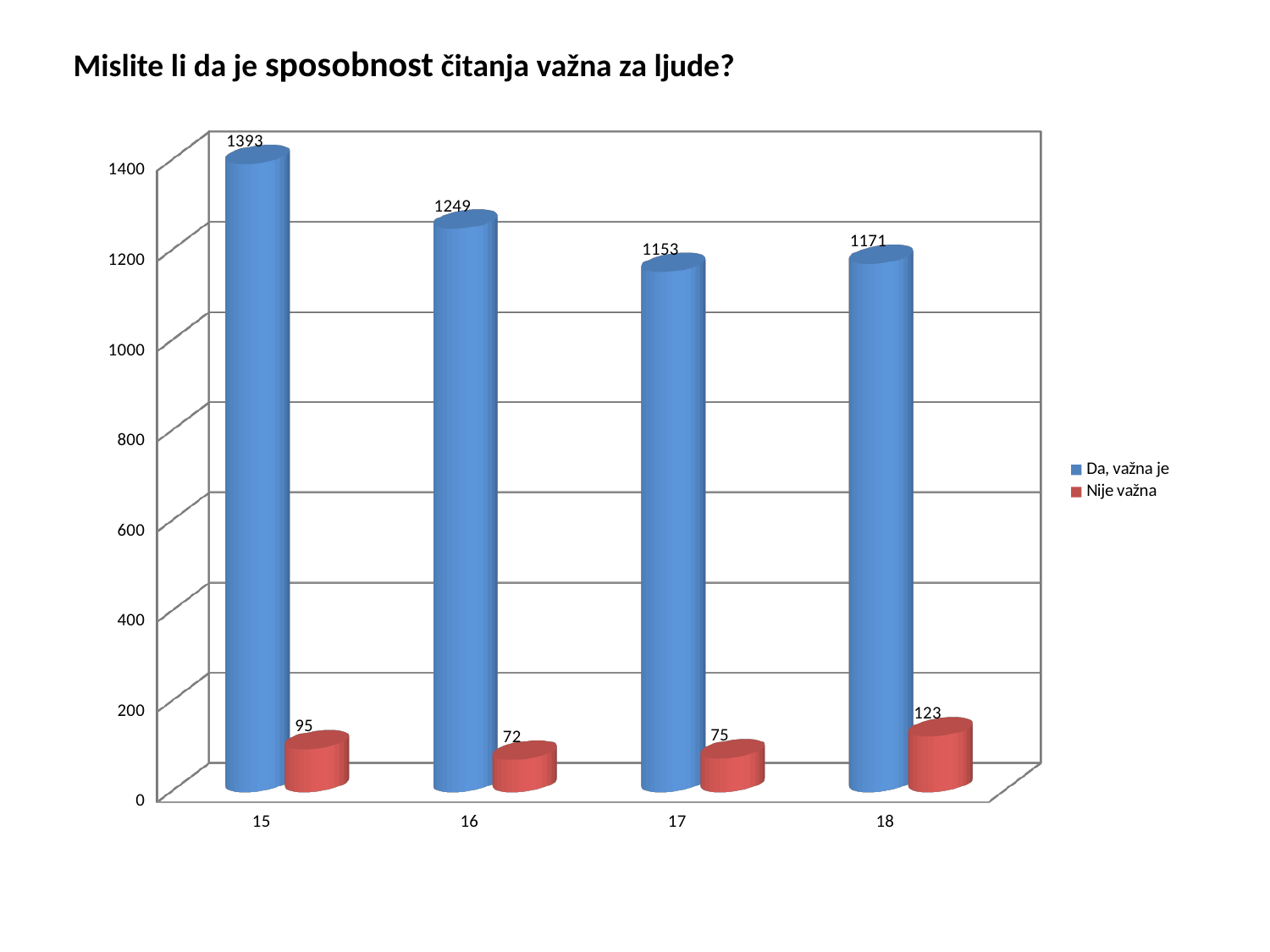
How many categories are shown on the x axis? 4 How many series does the legend list? 2 Which category has the highest value for "Da, važna je"? 15 What kind of chart is shown on the slide? bar chart Which is larger: the "Da, važna je" value for category 17 or for category 18? 18 Is the value for "Nije važna" at category 15 greater or less than 200? less What is the value for "Da, važna je" at category 17? 1153 What is the difference between the "Da, važna je" values for categories 15 and 16? 144 Which category has the lowest value for "Nije važna"? 16 What is the title of the chart? Mislite li da je sposobnost čitanja važna za ljude? What is the value for "Da, važna je" at category 15? 1393 What is the value for "Nije važna" at category 18? 123